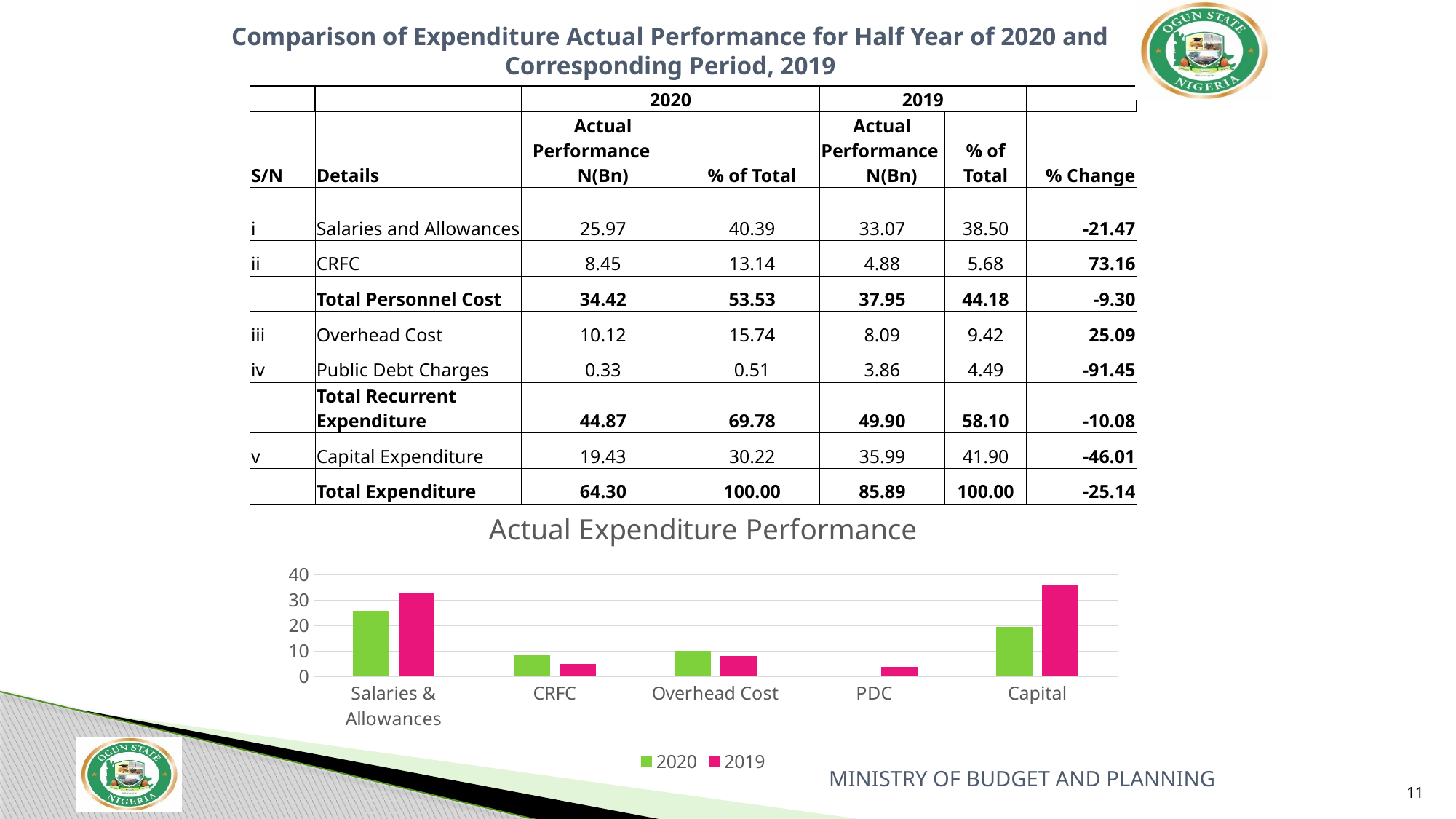
In the 'Actual Expenditure Performance' chart, which category has the highest 2020 bar? Salaries & Allowances In the 'Actual Expenditure Performance' chart, which category has the lowest 2020 bar? PDC What kind of chart is shown under the title 'Actual Expenditure Performance'? Bar chart In the 'Actual Expenditure Performance' chart, is the 2019 value for Capital greater or less than 30? greater How many categories are shown on the x axis of the 'Actual Expenditure Performance' chart? 5 In the 'Actual Expenditure Performance' chart, for CRFC, which series has the larger bar, 2020 or 2019? 2020 How many series does the legend of the 'Actual Expenditure Performance' chart list? 2 In the 'Actual Expenditure Performance' chart, which category has the highest 2019 bar? Capital What colour are the 2019 bars in the 'Actual Expenditure Performance' chart? Pink In the 'Actual Expenditure Performance' chart, is the 2020 value for Salaries & Allowances greater or less than 30? less In the 'Actual Expenditure Performance' chart, is the 2019 value for PDC greater or less than 10? less In the 'Actual Expenditure Performance' chart, for Salaries & Allowances, which series has the larger bar, 2020 or 2019? 2019